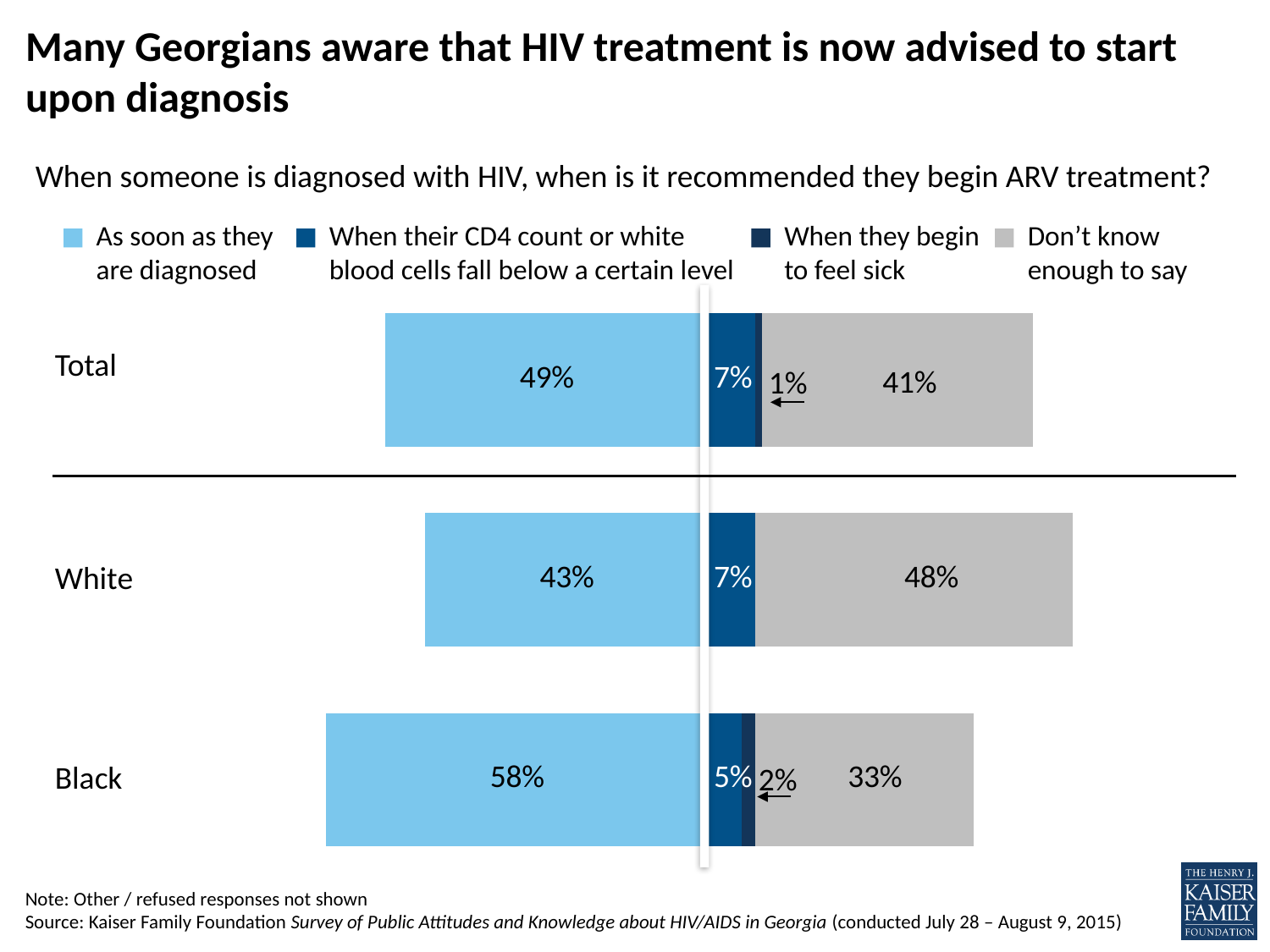
Which legend entry is shown in light blue? As soon as they are diagnosed What percentage of White respondents said they don't know enough to say? 48% How many groups are shown in the chart? 3 What kind of chart is shown on the slide? Stacked bar chart Which group has the highest share saying treatment should begin as soon as they are diagnosed? Black What is the difference between the share of Black and White respondents who said treatment should begin as soon as they are diagnosed? 15 percentage points Which group has the lowest share saying they don't know enough to say? Black What percentage of the Total group said treatment should begin when their CD4 count or white blood cells fall below a certain level? 7% Is the share of White respondents who don't know enough to say larger or smaller than the share of Total respondents who don't know enough to say? larger What percentage of Black respondents said treatment should begin when they begin to feel sick? 2% What percentage of Black respondents said ARV treatment should begin as soon as they are diagnosed? 58% How many response categories does the legend list? 4